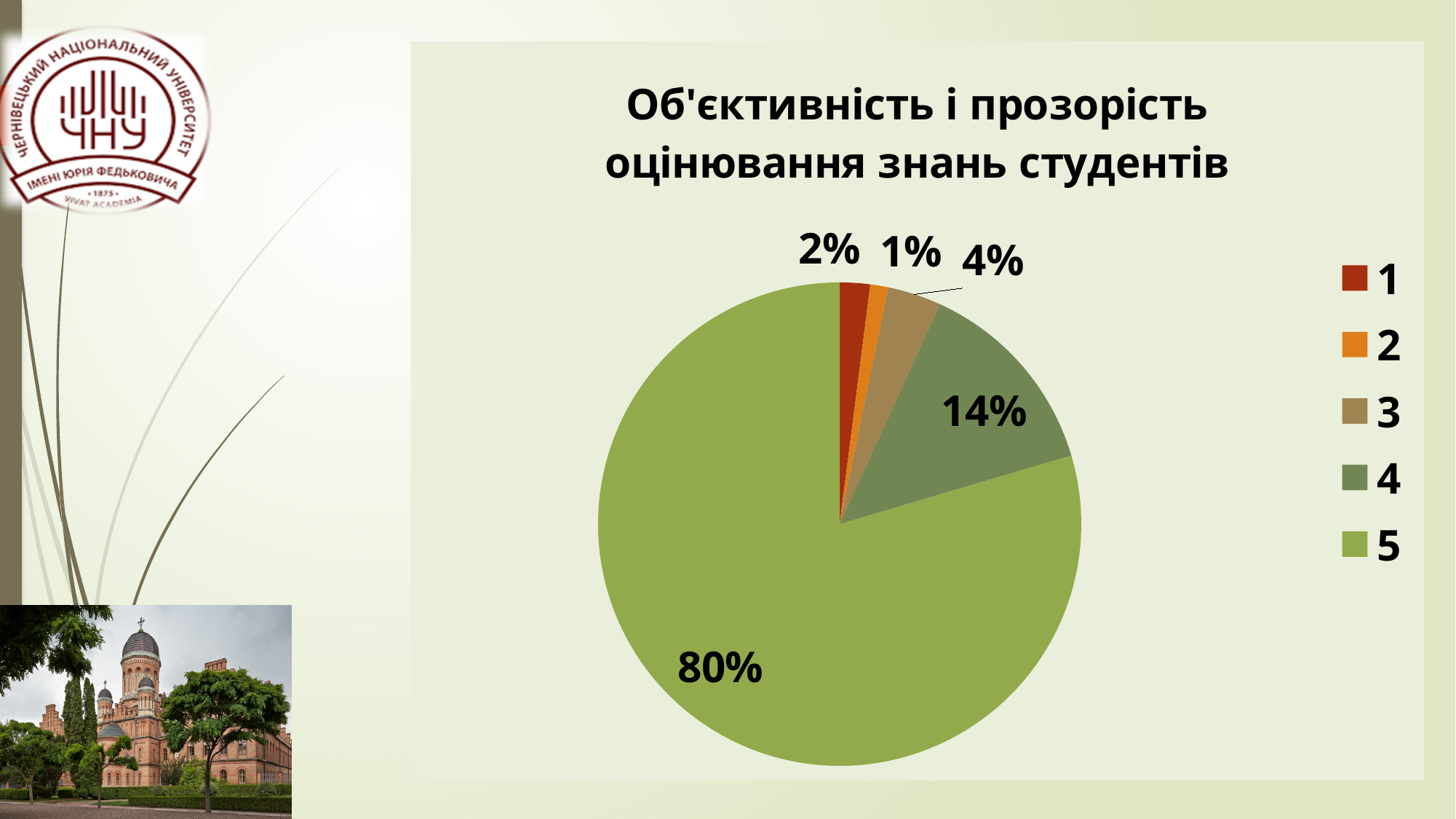
Which is larger, the slice for category 3 or the slice for category 1? 3 What is the value for category 2? 1% What is the difference between the shares of category 5 and category 4? 66% How many categories does the legend list? 5 Which category has the largest slice? 5 What kind of chart is shown on the slide? pie chart What is the value for category 3? 4% What share of the pie does category 4 have? 14% What is the title of the chart? Об'єктивність і прозорість оцінювання знань студентів What is the value for category 1? 2% Which category has the smallest slice? 2 What share of the pie does category 5 have? 80%